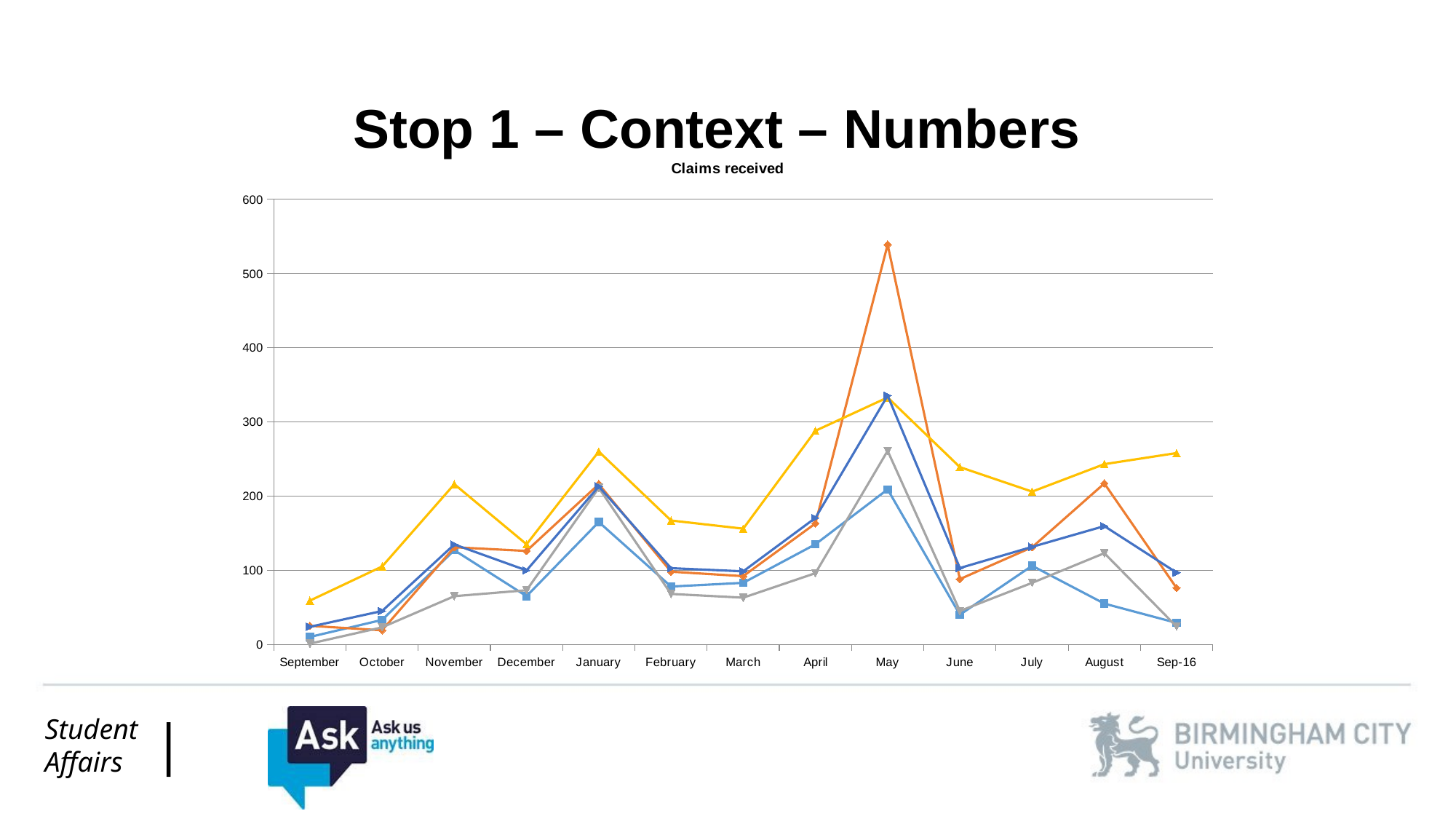
Between May and June, does the yellow line rise or fall? fall Is the value of the yellow line in September greater or less than 100? less What is the title of the chart? Claims received How many months are shown along the x axis of the chart? 13 Is the value of the grey line in May greater or less than 200? greater Is the value of the orange line in May greater or less than 500? greater In which month does the orange line reach its highest value? May In May, which is higher: the orange line or the yellow line? orange line How many lines are plotted on the chart? 5 In which month is the yellow line at its lowest value? September What kind of chart is shown on the slide? line chart